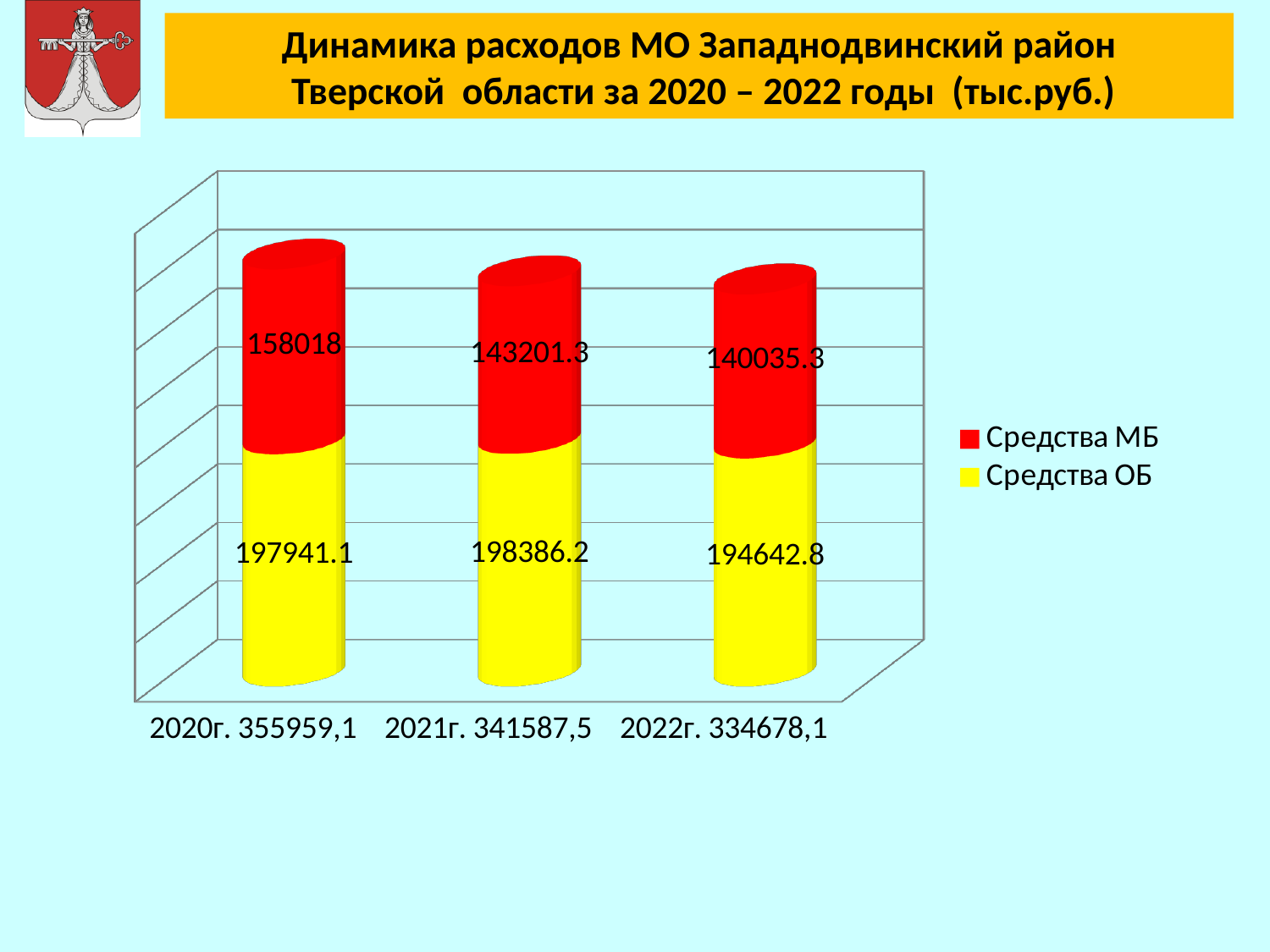
In which year is Средства ОБ the lowest? 2022г. How many series does the legend list? 2 What is the value of Средства МБ for 2020г.? 158018 What is the total of the stacked bar for 2020г.? 355959,1 Does Средства МБ rise or fall from 2020г. to 2022г.? fall What is the value of Средства МБ for 2022г.? 140035.3 What is the value of Средства ОБ for 2022г.? 194642.8 Which is larger in 2021г.: Средства МБ or Средства ОБ? Средства ОБ What is the difference between Средства МБ in 2020г. and in 2021г.? 14816.7 How many years are shown on the x axis? 3 In which year is Средства МБ the highest? 2020г. What is the value of Средства ОБ for 2021г.? 198386.2